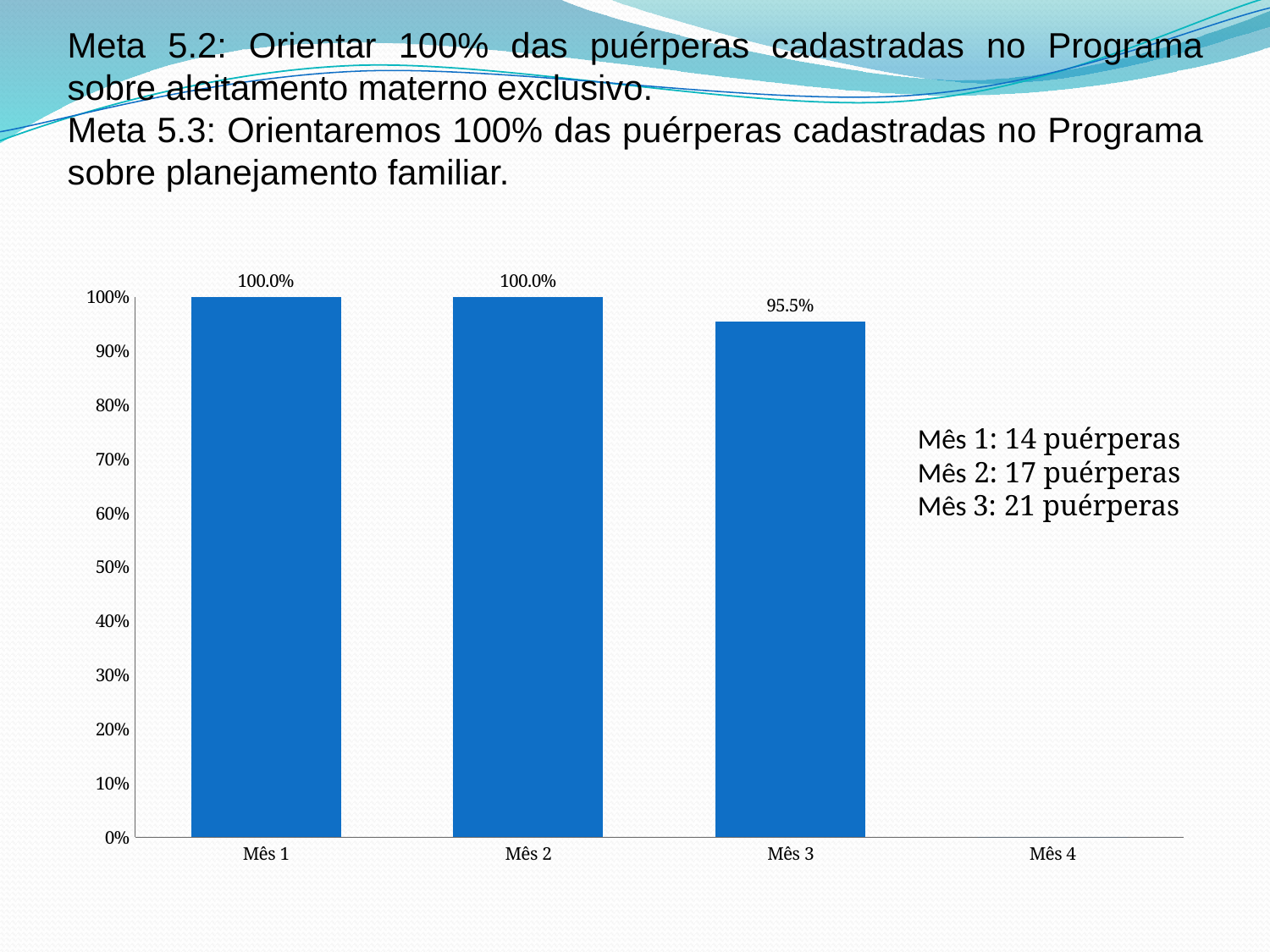
What is the difference between the values for Mês 1 and Mês 3? 4.5% Which is larger, the value for Mês 2 or the value for Mês 3? Mês 2 How many categories are labelled on the x axis? 4 What kind of chart is shown on the slide? bar chart What is the value for Mês 3? 95.5% Which month has the lowest value among the bars shown? Mês 3 How many bars are plotted in the chart? 3 What is the value for Mês 1? 100.0% What is the value for Mês 2? 100.0% Is the value for Mês 3 greater or less than 90%? greater Do the values rise or fall from Mês 2 to Mês 3? fall What colour are the bars in the chart? blue